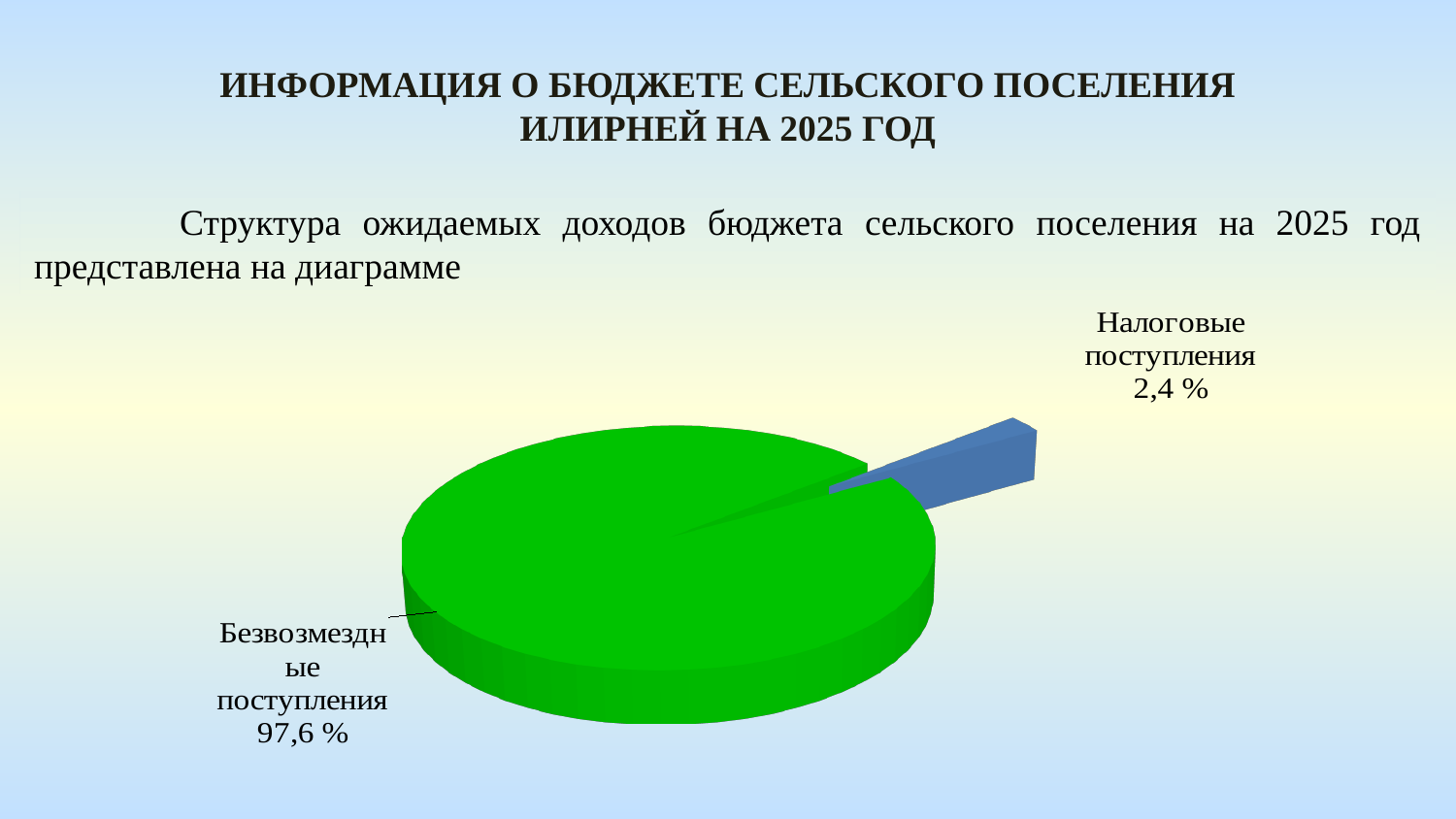
How many slices does the pie chart have? 2 Which is larger: the share for "Налоговые поступления" or the share for "Безвозмездные поступления"? Безвозмездные поступления What share of the pie does "Налоговые поступления" represent? 2,4 % What share of the pie does "Безвозмездные поступления" represent? 97,6 % What kind of chart is shown on the slide? pie chart Which category has the smallest share of the pie? Налоговые поступления What colour is the slice for "Безвозмездные поступления"? green What is the difference in percentage points between "Безвозмездные поступления" and "Налоговые поступления"? 95,2 What colour is the slice for "Налоговые поступления"? blue Which category has the largest share of the pie? Безвозмездные поступления